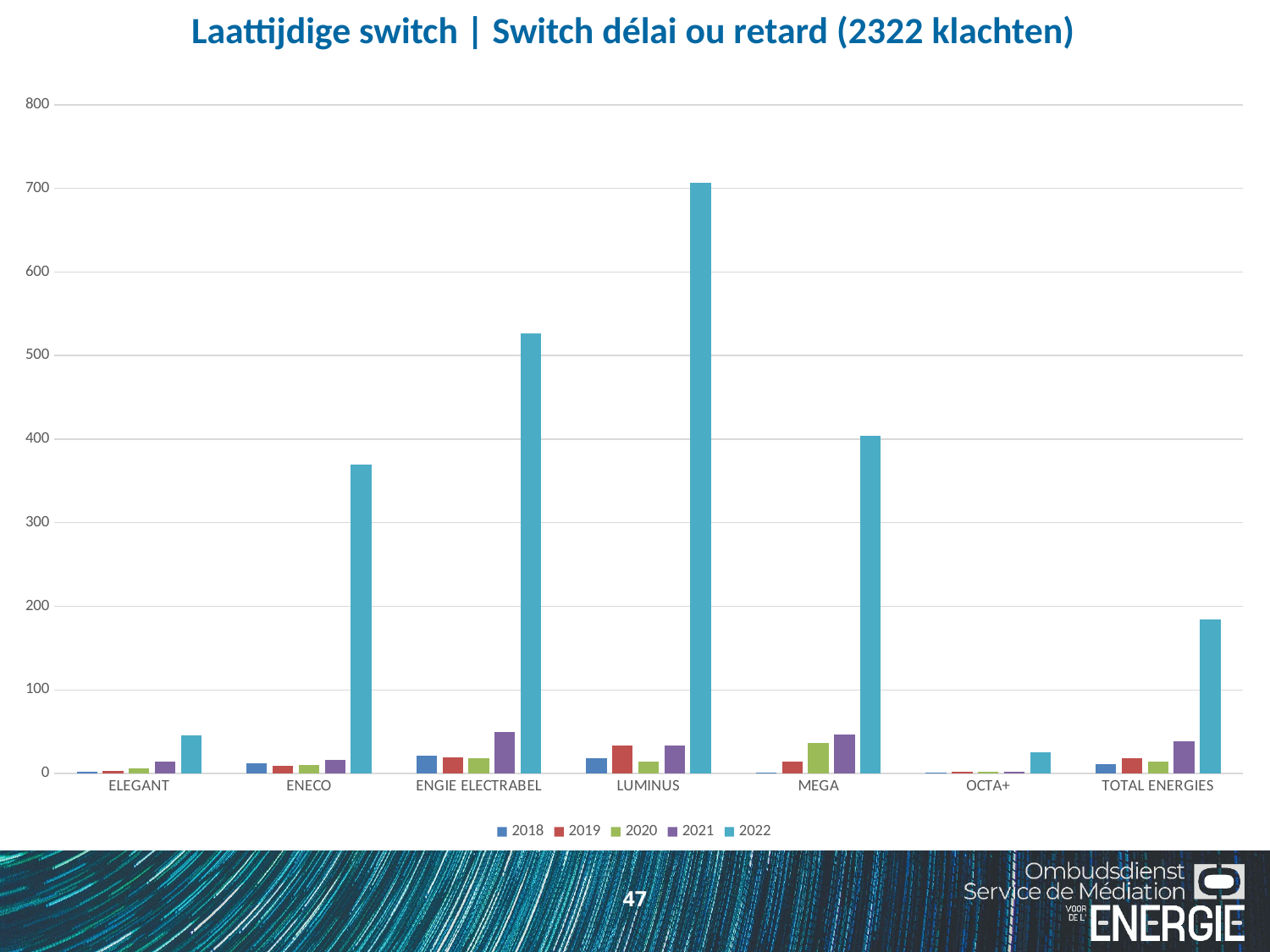
Which supplier has the lowest value for 2022? OCTA+ Is the 2022 value for ENGIE ELECTRABEL greater or less than 500? greater Which is larger: the 2022 value for MEGA or the 2022 value for ENECO? MEGA How many series does the legend list? 5 What kind of chart is shown on the slide? bar chart Is the 2022 value for ENECO greater or less than 400? less Which is larger: the 2022 value for ENGIE ELECTRABEL or the 2022 value for MEGA? ENGIE ELECTRABEL What is the title of the chart? Laattijdige switch | Switch délai ou retard (2322 klachten) Is the 2022 value for LUMINUS greater or less than 600? greater How many supplier categories are shown on the x axis? 7 Which supplier has the highest value for 2022? LUMINUS